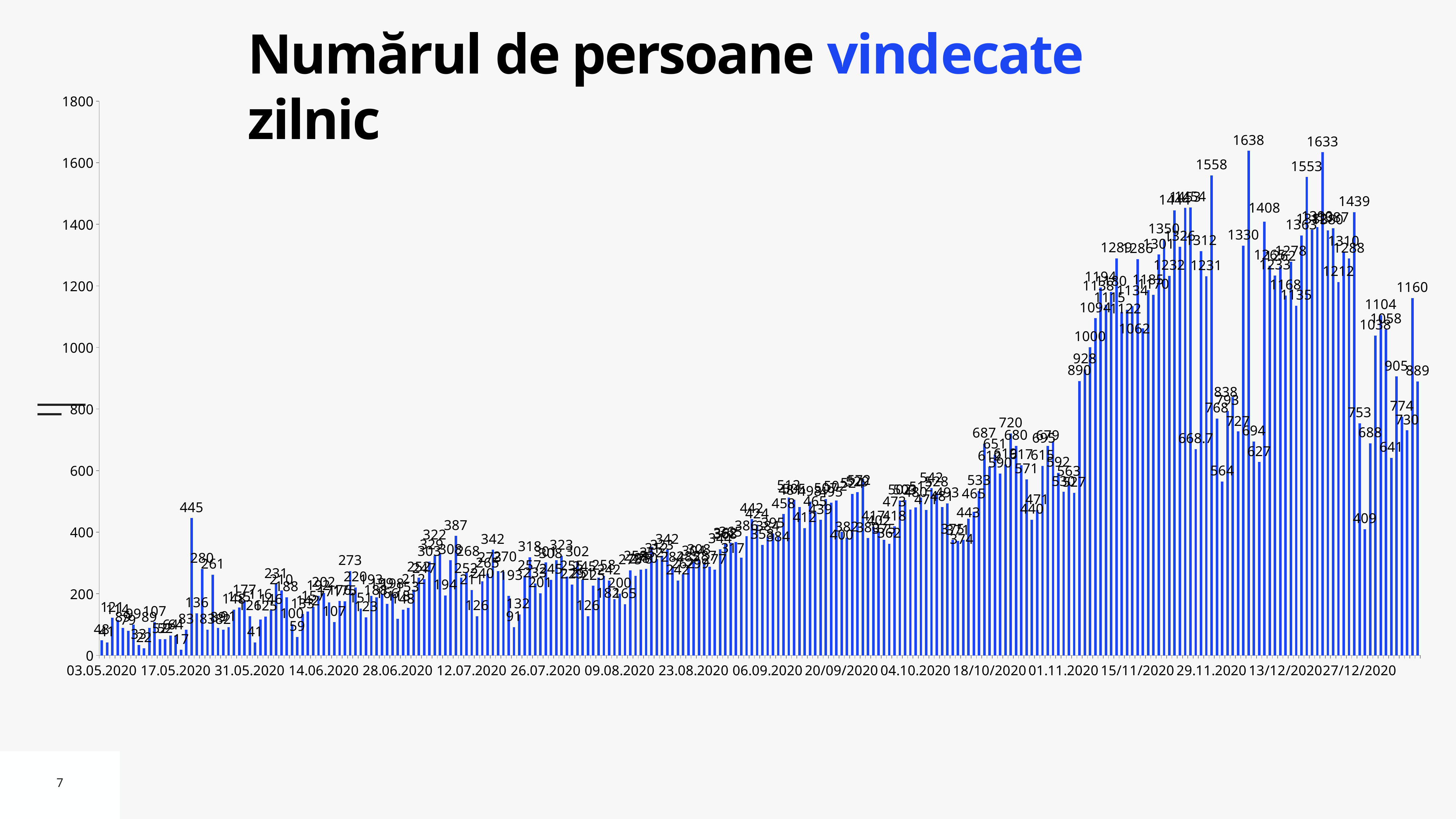
What is the difference between the highest value, 1638, and the bar labelled 1558? 80 Which is larger, the bar labelled 445 in May or the bar labelled 387 in July? 445 What is the value of the tallest bar on the chart? 1638 What is the highest value shown on the y axis? 1800 Overall, do the values rise or fall from May 2020 to December 2020? rise What kind of chart is shown on the slide? bar chart What is the lowest value labelled on the chart? 17 What is the difference between the two highest labelled values, 1638 and 1633? 5 What is the title of the chart? Numărul de persoane vindecate zilnic Is the value of the rightmost bar greater or less than 800? greater Is the value of the first bar on the left greater or less than 200? less What is the value of the last (rightmost) bar on the chart? 889